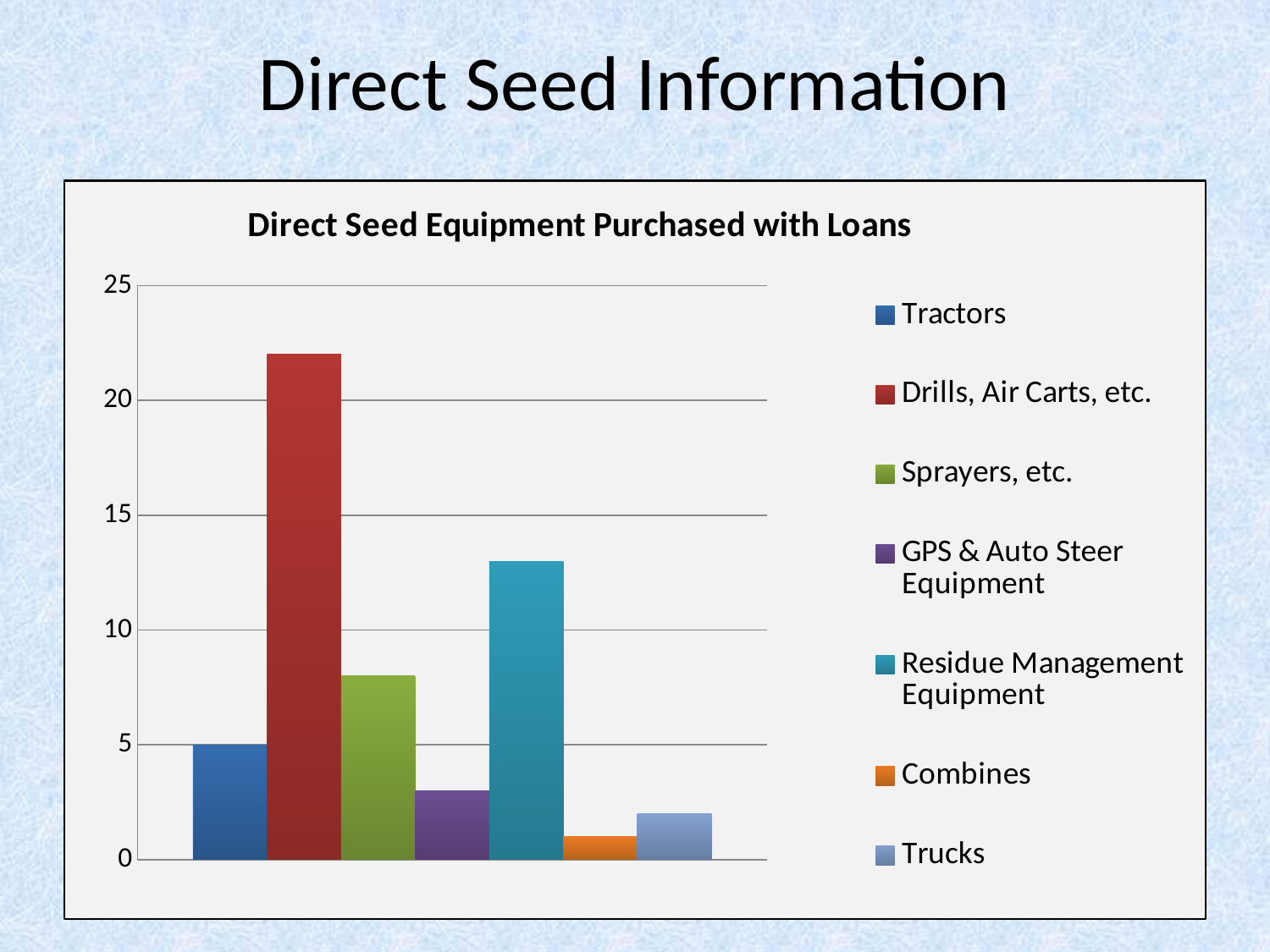
What is the title of the chart? Direct Seed Equipment Purchased with Loans Is the value for Residue Management Equipment greater or less than 15? less Is the value for GPS & Auto Steer Equipment greater or less than 5? less Is the value for Drills, Air Carts, etc. greater or less than 20? greater Which is larger, the value for Residue Management Equipment or the value for Sprayers, etc.? Residue Management Equipment What is the value for Tractors? 5 Which equipment category has the highest bar? Drills, Air Carts, etc. Which equipment category has the lowest bar? Combines Which is larger, the value for Trucks or the value for Combines? Trucks What type of chart is shown on the slide? Bar chart How many series does the legend list? 7